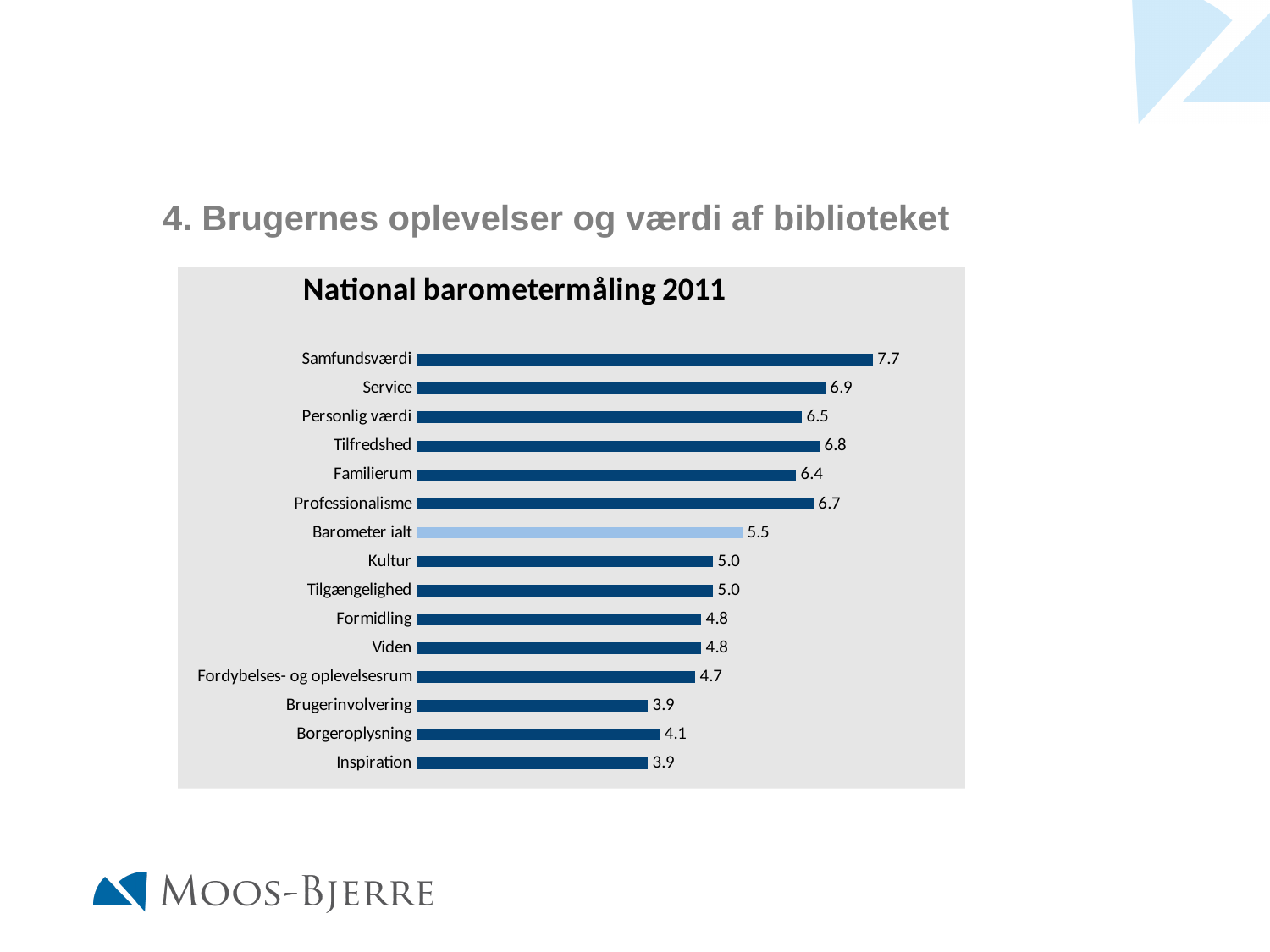
What is the difference between the values for Service and Familierum? 0.5 Which is larger, the value for Tilfredshed or the value for Personlig værdi? Tilfredshed What is the value for Barometer ialt? 5.5 What is the value for Borgeroplysning? 4.1 What is the value for Fordybelses- og oplevelsesrum? 4.7 Which bar is shown in a lighter blue colour than the others? Barometer ialt What kind of chart is shown on the slide? Bar chart Which category has the highest value? Samfundsværdi What is the difference between the values for Samfundsværdi and Inspiration? 3.8 What is the value for Samfundsværdi? 7.7 What is the title of the chart? National barometermåling 2011 How many categories are shown in the chart? 15